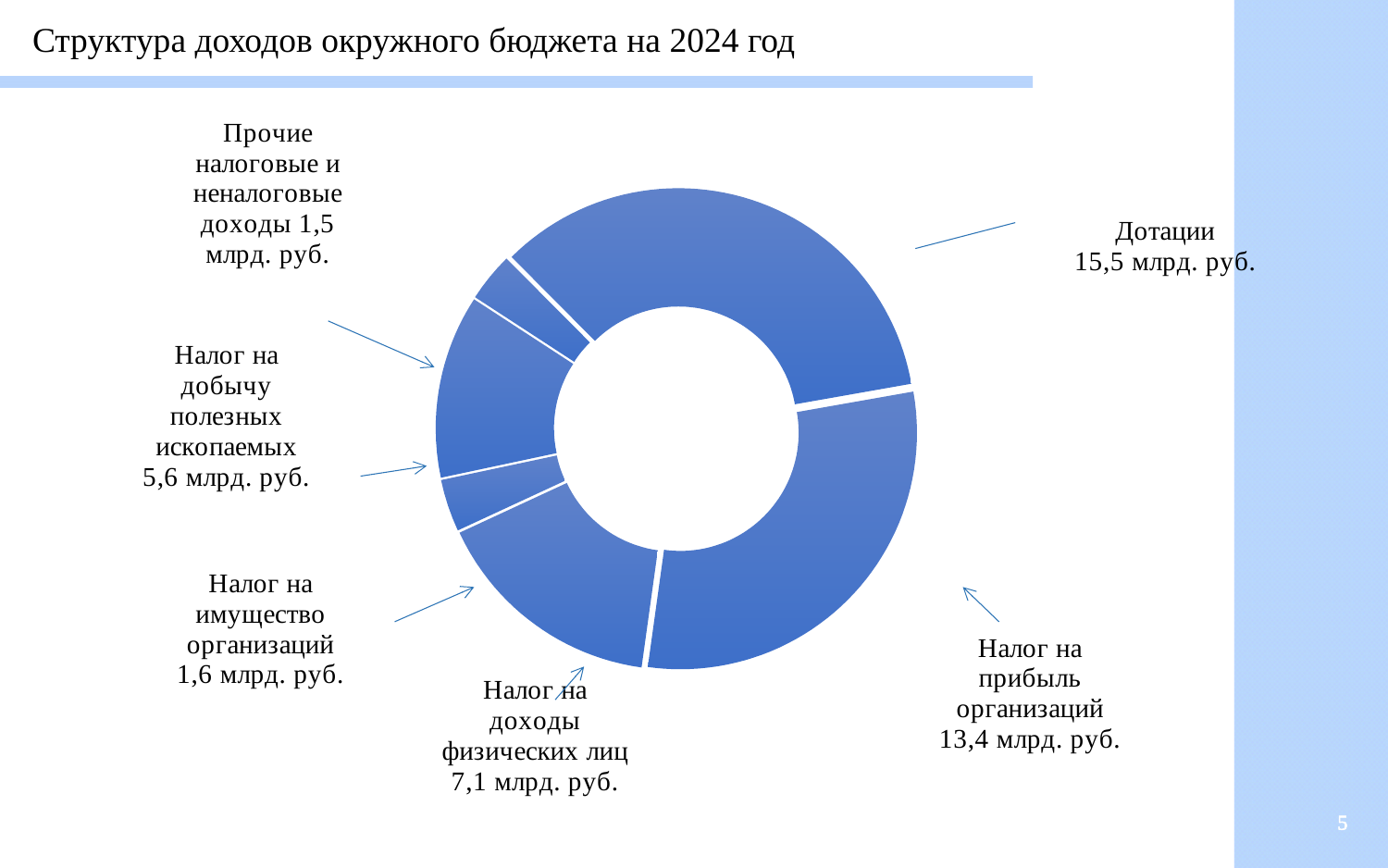
What is the title of the slide? Структура доходов окружного бюджета на 2024 год Which is larger, Налог на доходы физических лиц or Налог на добычу полезных ископаемых? Налог на доходы физических лиц What kind of chart is shown on the slide? doughnut chart What is the value for Налог на добычу полезных ископаемых? 5,6 млрд. руб. Which category has the highest value? Дотации How many categories are shown in the chart? 6 What is the value for Дотации? 15,5 млрд. руб. Which category has the lowest value? Прочие налоговые и неналоговые доходы What is the value for Налог на прибыль организаций? 13,4 млрд. руб. What is the value for Налог на доходы физических лиц? 7,1 млрд. руб. What is the difference between Дотации and Налог на прибыль организаций? 2,1 млрд. руб. What is the value for Налог на имущество организаций? 1,6 млрд. руб.